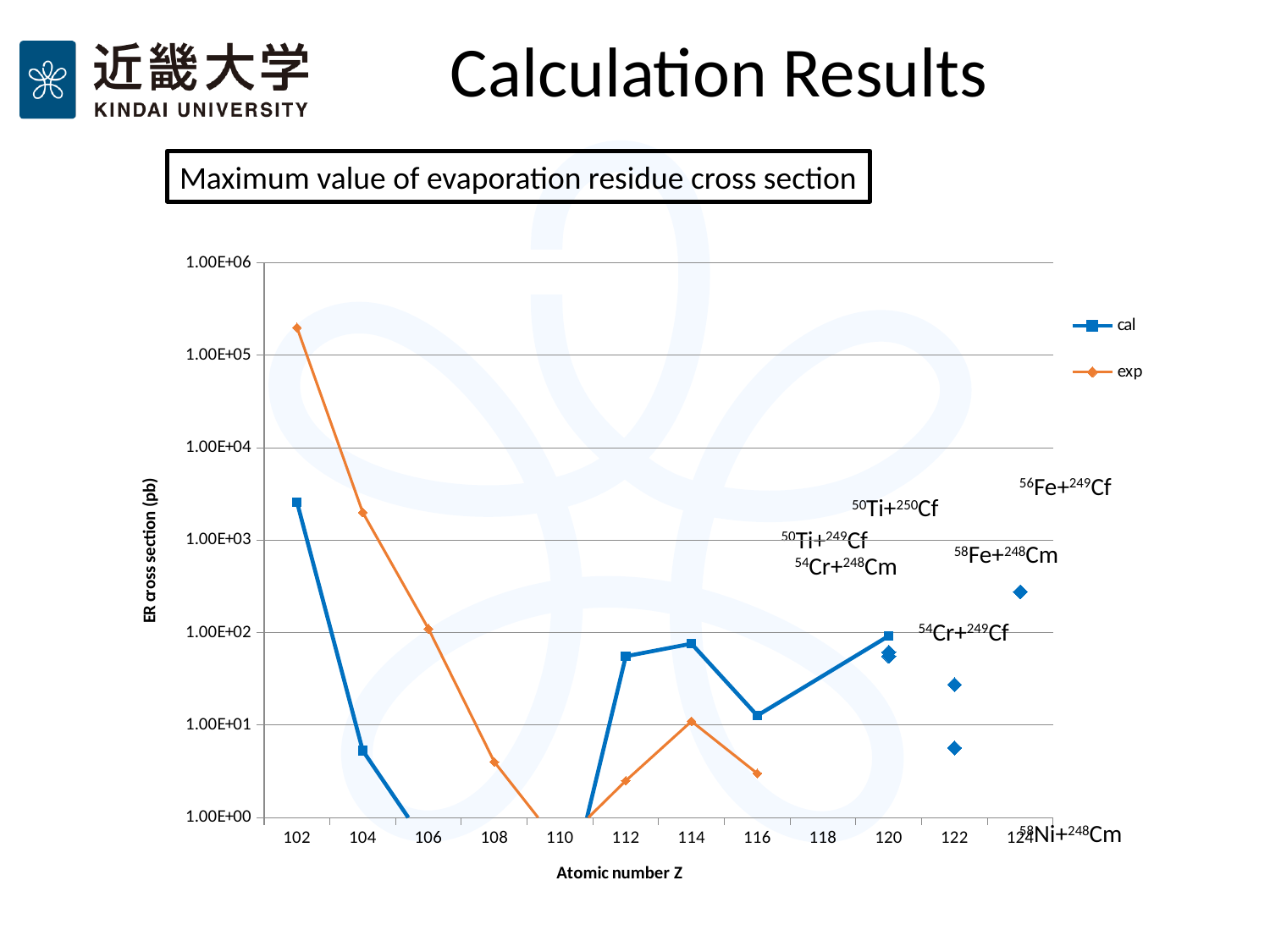
Is the exp value at Z = 102 greater or less than 1.00E+05? greater At Z = 114, which series has the larger value, cal or exp? cal What is the title of the y axis of the chart? ER cross section (pb) Is the cal value at Z = 104 greater or less than 1.00E+01? less Is the cal value at Z = 114 greater or less than 1.00E+02? less Does the exp series rise or fall from Z = 102 to Z = 108? fall How many series does the chart legend list? 2 What is the title of the x axis of the chart? Atomic number Z What kind of chart is shown on the slide? line chart At Z = 102, which series has the larger value, cal or exp? exp